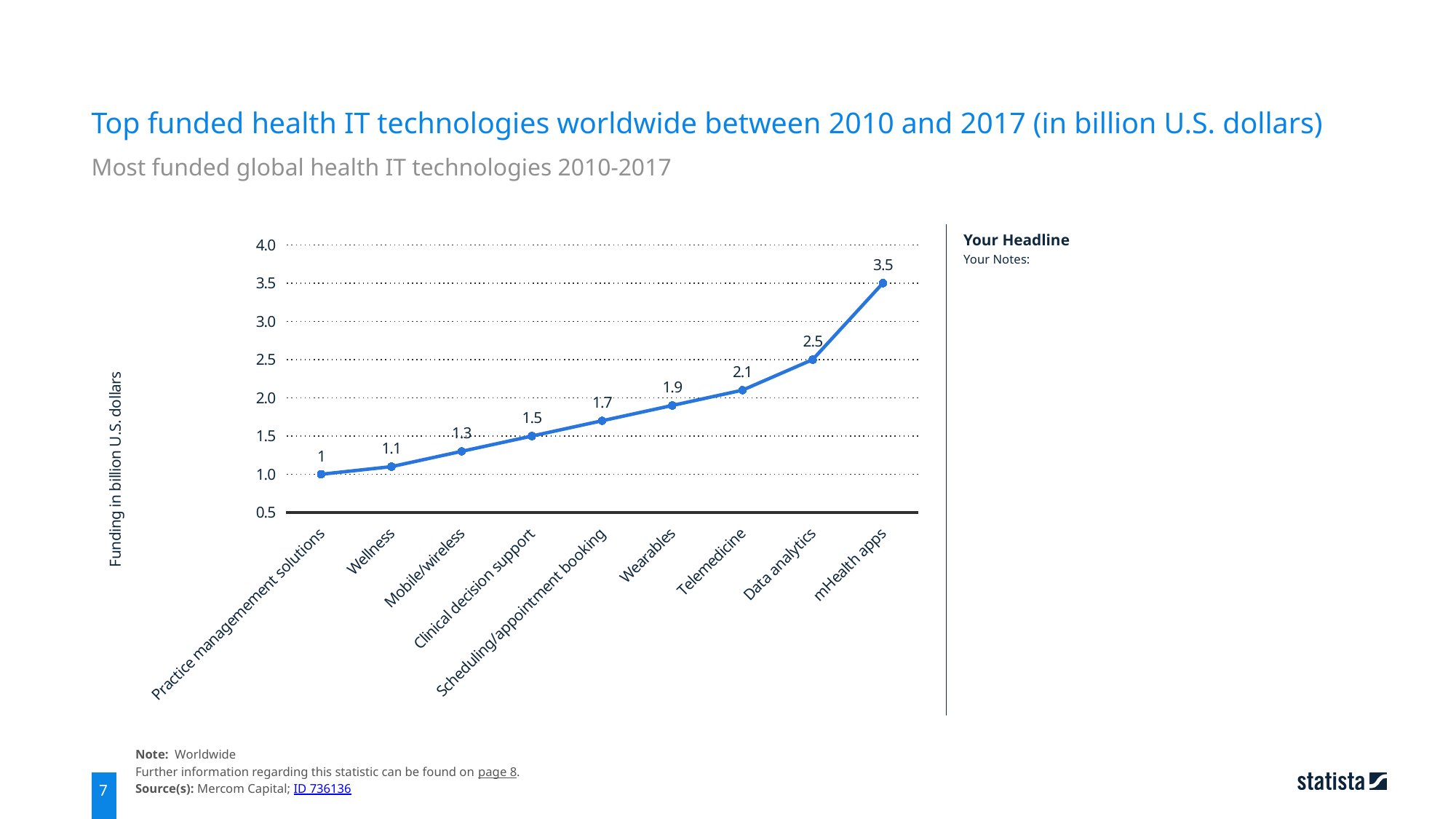
What is the funding value for Telemedicine? 2.1 What is the difference between the funding values for Wearables and Wellness? 0.8 Do the values rise or fall from left to right along the x axis? Rise How many technologies are plotted on the chart? 9 What is the funding value for Practice management solutions? 1 What is the funding value for mHealth apps? 3.5 What is the difference between the funding values for mHealth apps and Data analytics? 1 What is the label of the y axis? Funding in billion U.S. dollars Which technology has the lowest funding value? Practice management solutions Which technology has the highest funding value? mHealth apps Which has a higher funding value, Clinical decision support or Scheduling/appointment booking? Scheduling/appointment booking What kind of chart is shown on the slide? Line chart